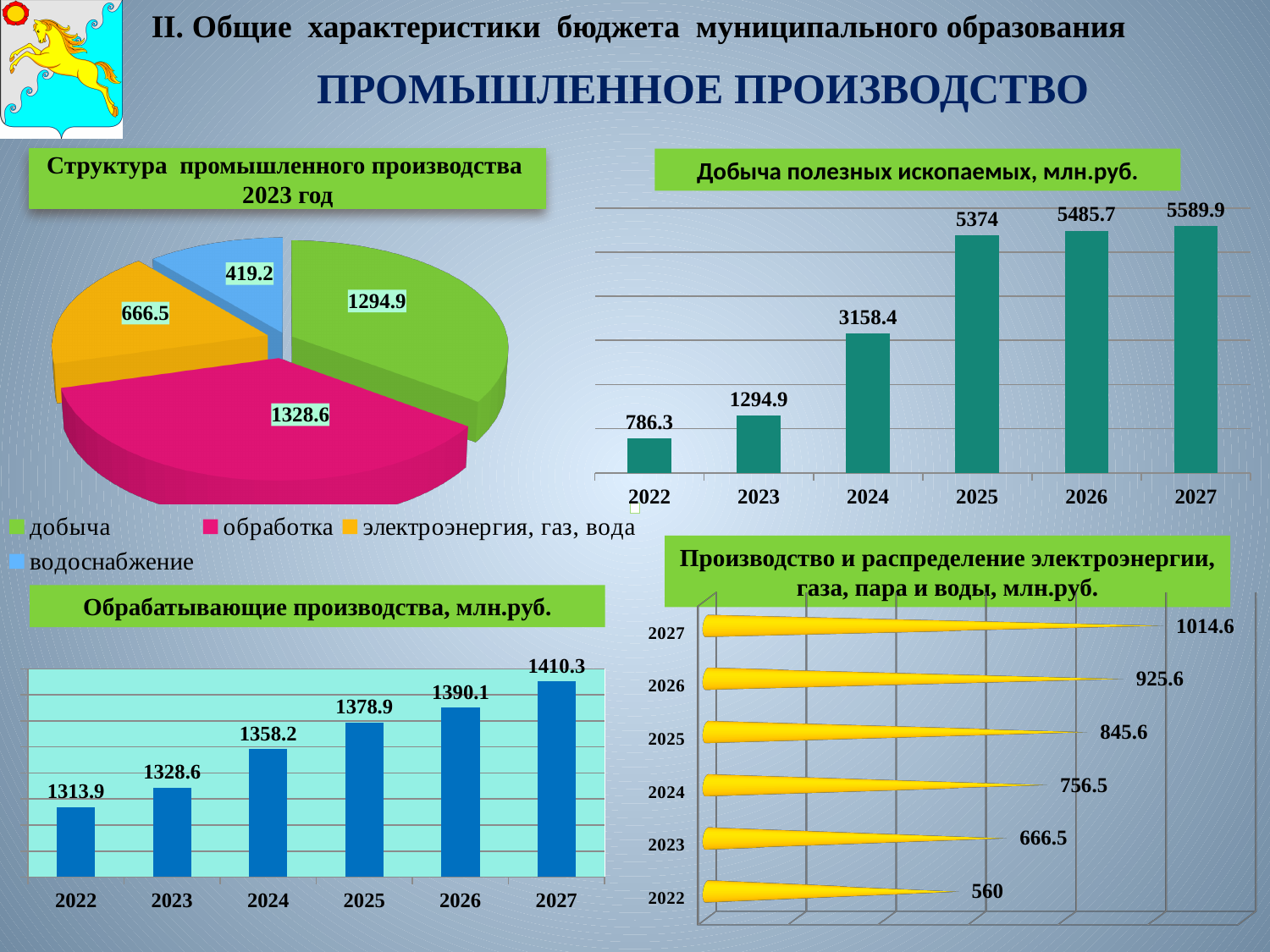
In the chart 'Обрабатывающие производства, млн.руб.', what is the value for 2025? 1378.9 In the chart 'Обрабатывающие производства, млн.руб.', what is the difference between the values for 2027 and 2026? 20.2 In the pie chart 'Структура промышленного производства 2023 год', which category has the largest slice? обработка In the chart 'Производство и распределение электроэнергии, газа, пара и воды, млн.руб.', do the values rise or fall from 2022 to 2027? rise How many years are shown in the chart 'Добыча полезных ископаемых, млн.руб.'? 6 In the chart 'Производство и распределение электроэнергии, газа, пара и воды, млн.руб.', what is the value for 2022? 560 In the chart 'Добыча полезных ископаемых, млн.руб.', what is the value for 2024? 3158.4 How many categories does the legend of the pie chart 'Структура промышленного производства 2023 год' list? 4 In the pie chart 'Структура промышленного производства 2023 год', which is larger: добыча or электроэнергия, газ, вода? добыча What kind of chart is 'Обрабатывающие производства, млн.руб.'? bar chart In the chart 'Добыча полезных ископаемых, млн.руб.', what is the difference between the values for 2027 and 2022? 4803.6 In the pie chart 'Структура промышленного производства 2023 год', which category has the smallest slice? водоснабжение